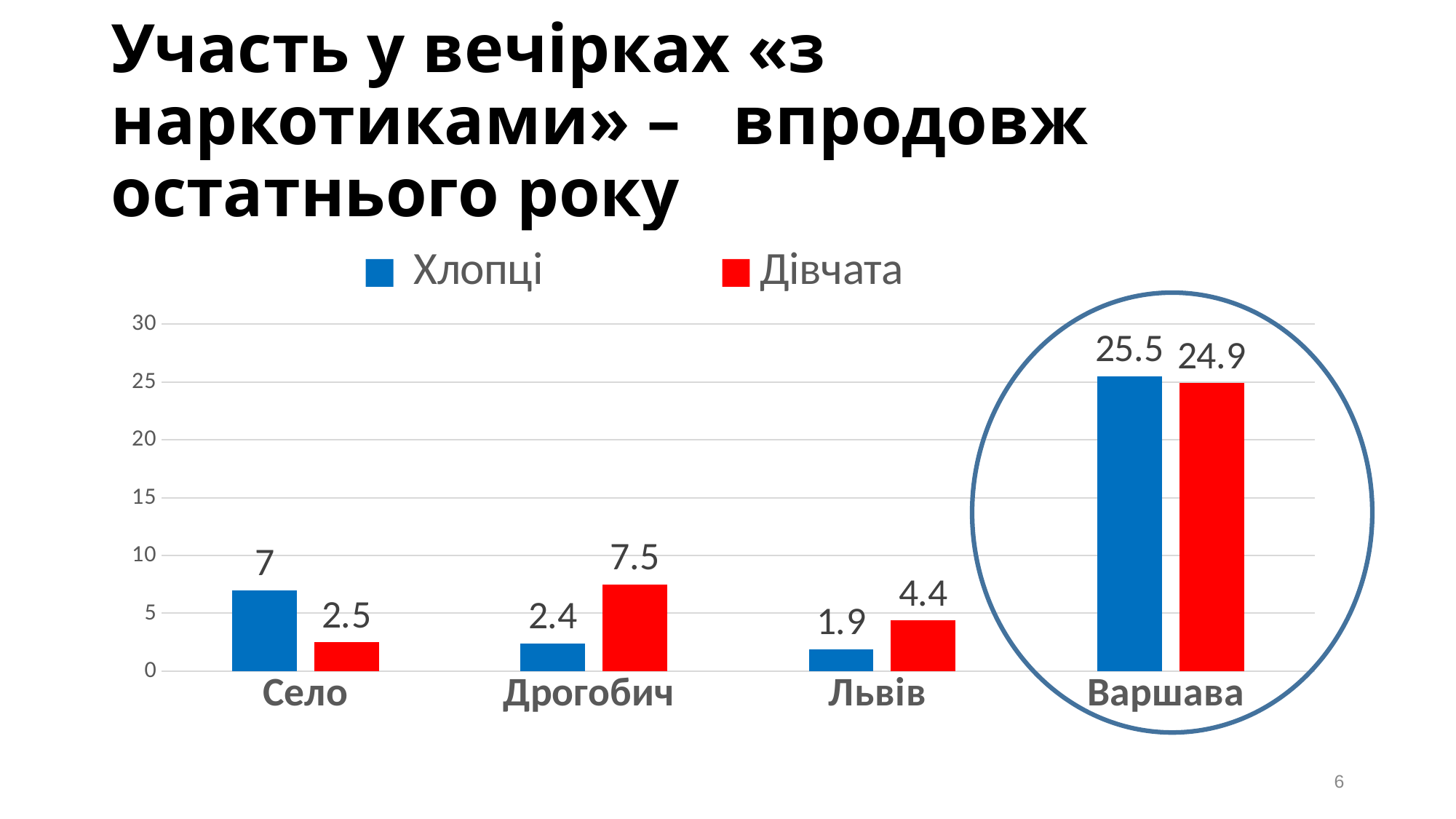
What colour represents the Дівчата series? Red What is the value for Хлопці in Варшава? 25.5 How many series does the legend list? 2 What kind of chart is shown on the slide? Bar chart What is the value for Дівчата in Дрогобич? 7.5 Which category has the lowest value for Хлопці? Львів What is the difference between the Хлопці and Дівчата values in Село? 4.5 What is the value for Хлопці in Село? 7 How many categories are shown on the x axis? 4 What is the value for Дівчата in Львів? 4.4 Which is larger in Дрогобич, the value for Хлопці or for Дівчата? Дівчата Which category has the highest value for Дівчата? Варшава